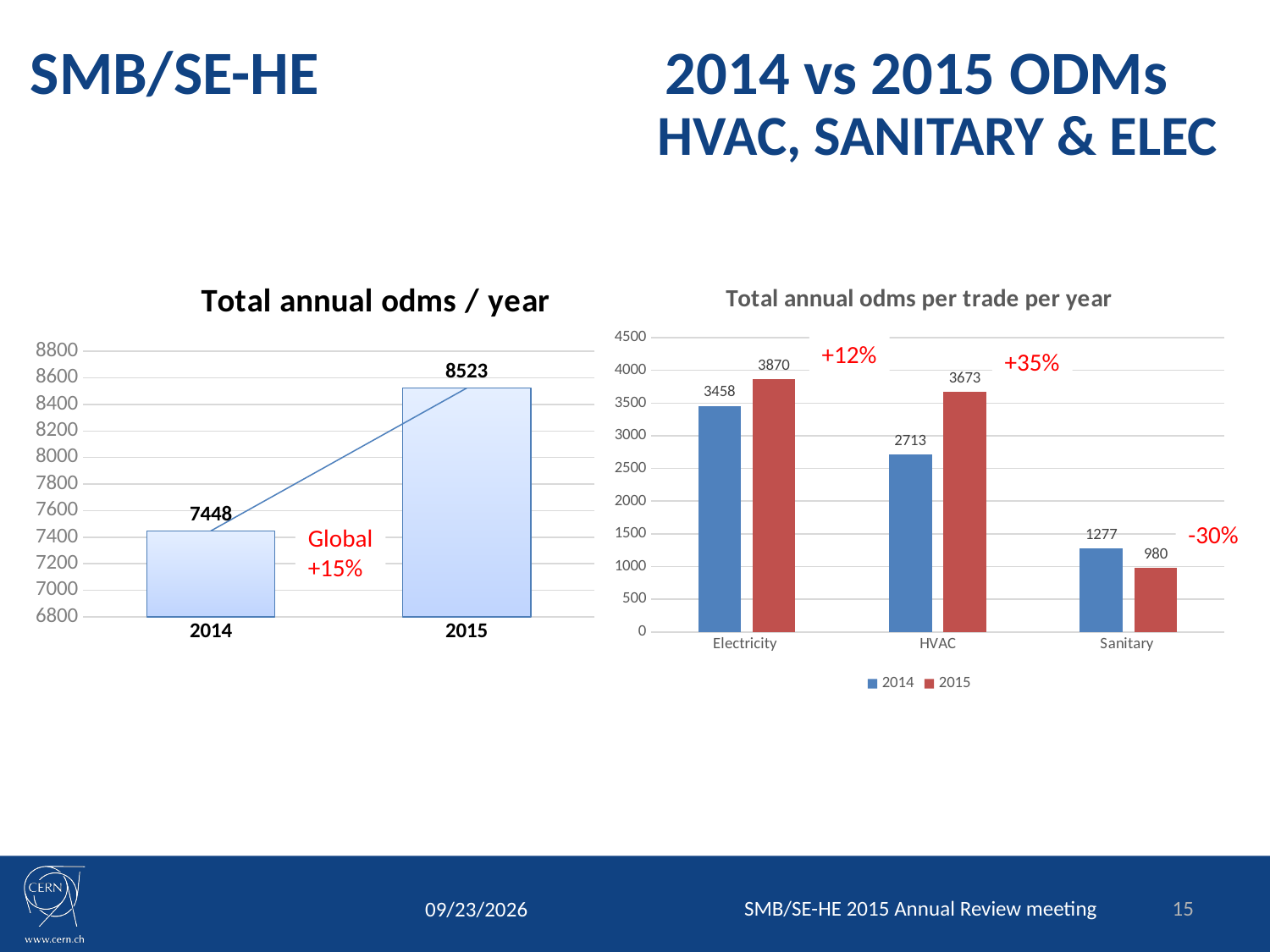
In the 'Total annual odms per trade per year' chart, what is the 2014 value for Sanitary? 1277 In the 'Total annual odms per trade per year' chart, what is the 2015 value for HVAC? 3673 In the 'Total annual odms per trade per year' chart, what is the difference between the 2015 and 2014 values for HVAC? 960 In the 'Total annual odms per trade per year' chart, which is larger for Sanitary: the 2014 value or the 2015 value? 2014 In the 'Total annual odms / year' chart, what is the value for 2015? 8523 In the 'Total annual odms / year' chart, what is the value for 2014? 7448 How many series does the legend of the 'Total annual odms per trade per year' chart list? 2 In the 'Total annual odms / year' chart, what is the difference between the 2015 and 2014 values? 1075 What kind of chart is the 'Total annual odms per trade per year' chart? bar chart In the 'Total annual odms per trade per year' chart, which trade has the lowest 2014 value? Sanitary In the 'Total annual odms per trade per year' chart, which trade has the highest 2015 value? Electricity In the 'Total annual odms / year' chart, do the values rise or fall from 2014 to 2015? rise